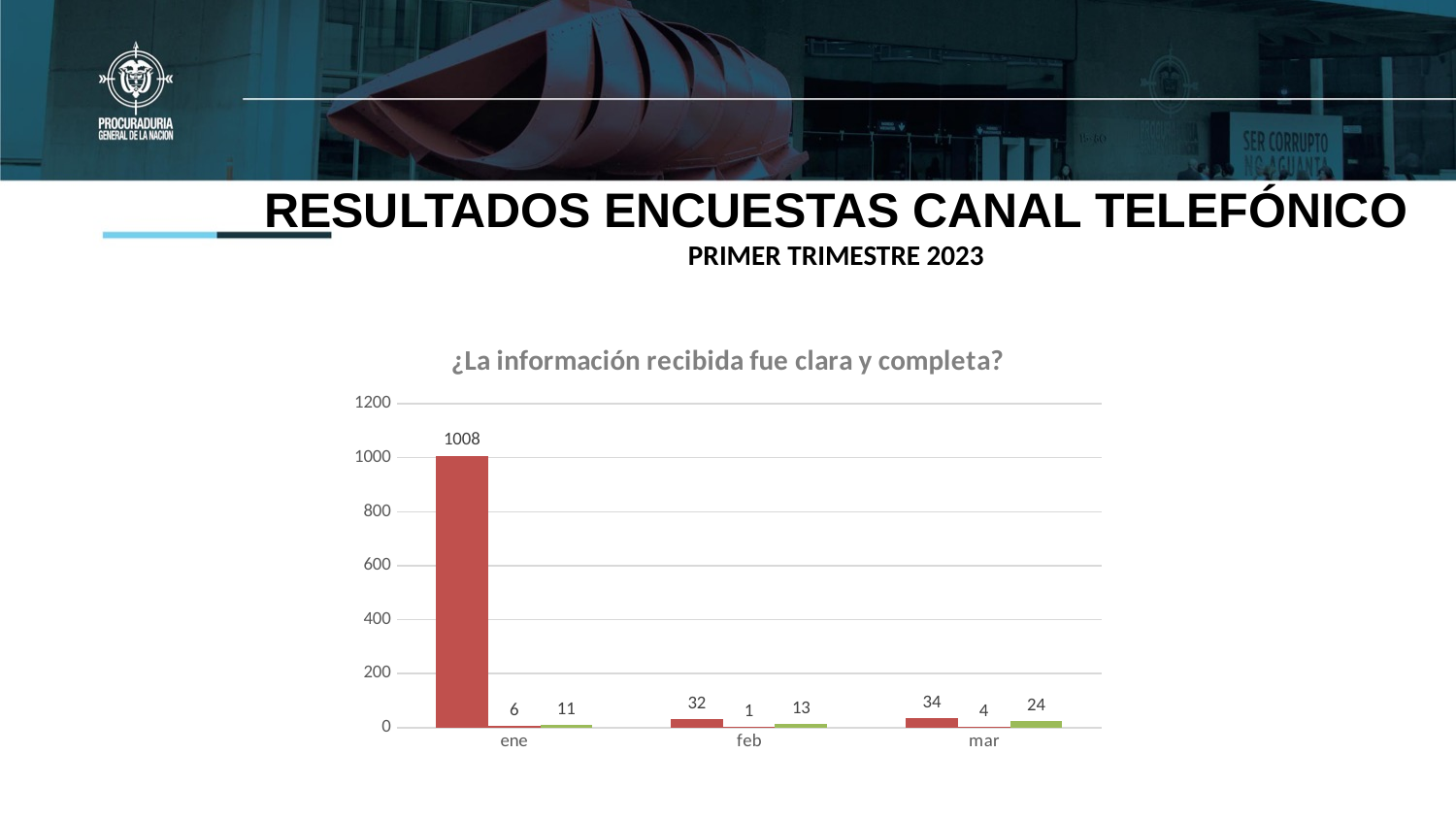
What is the difference between the green bar for mar and the green bar for feb? 11 What is the value of the red bar for ene? 1008 Which month has the larger red bar, feb or mar? mar How many months are shown on the x axis? 3 Which month has the highest red bar? ene What kind of chart is shown on the slide? bar chart What is the title of the chart? ¿La información recibida fue clara y completa? What is the value of the green bar for mar? 24 What is the lowest value labelled on the chart? 1 How many bars are shown for each month? 3 Is the value of the red bar for ene greater or less than 1000? greater What is the value of the small middle bar for feb? 1